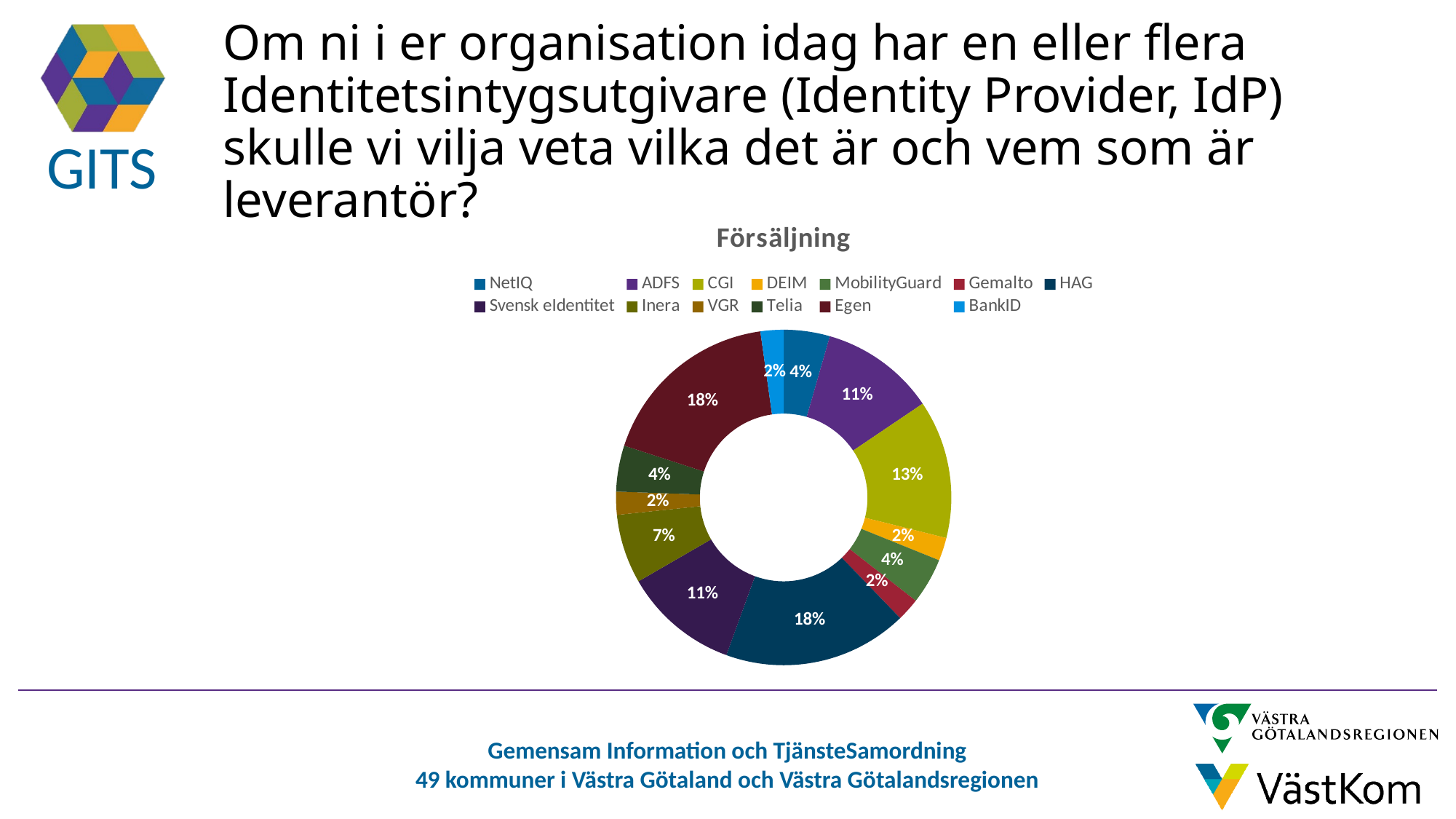
What share of the chart does HAG account for? 18% Which is larger, the share for ADFS or the share for Inera? ADFS What is the difference in percentage points between the share for HAG and the share for CGI? 5 What is the title of the chart? Försäljning What type of chart is shown on the slide? doughnut chart Which is larger, the share for CGI or the share for Svensk eIdentitet? CGI What share of the chart does NetIQ account for? 4% How many categories does the chart's legend list? 13 What share of the chart does Inera account for? 7% What share of the chart does BankID account for? 2% What share of the chart does Egen account for? 18% What share of the chart does CGI account for? 13%